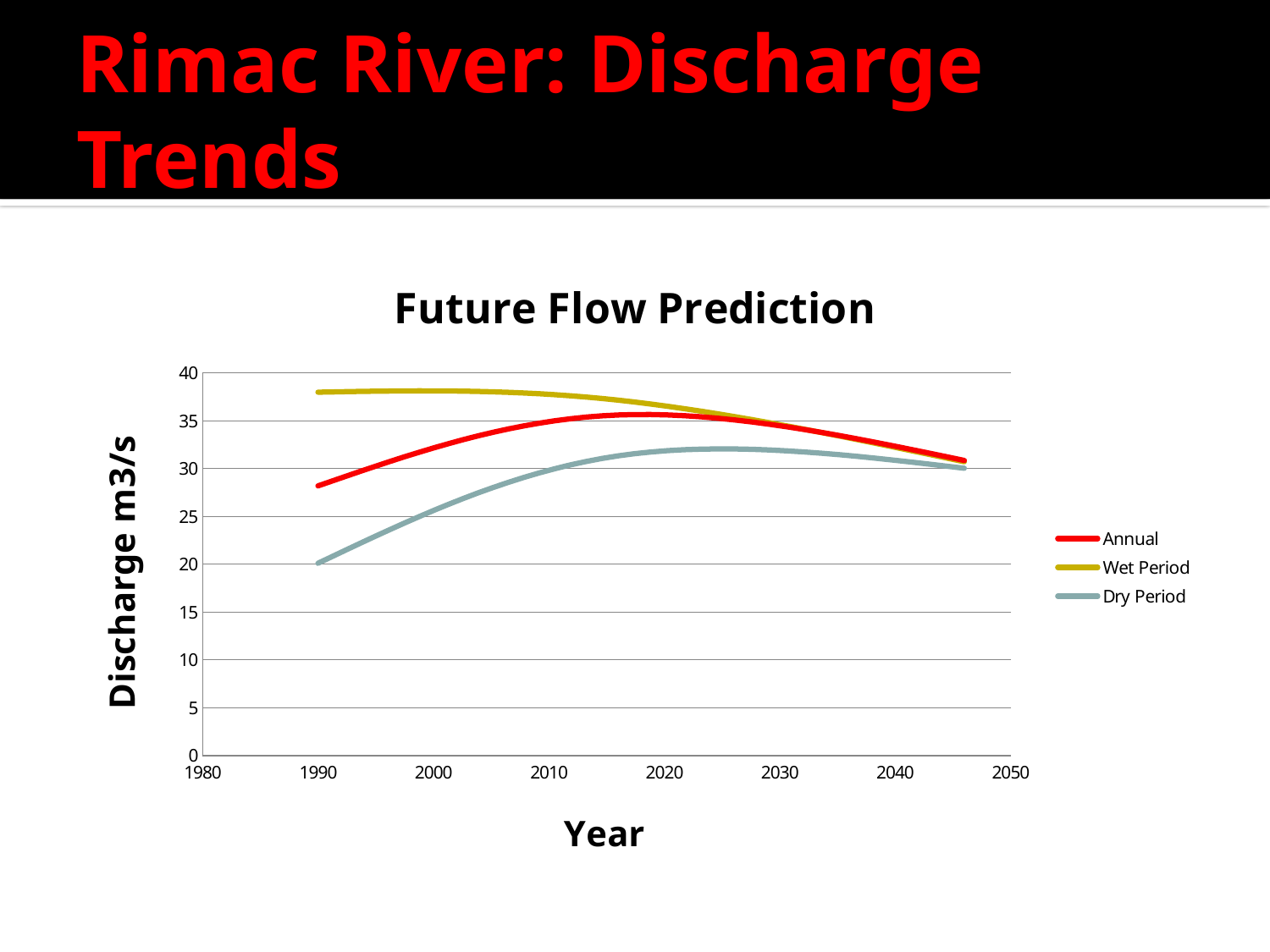
Does the Dry Period line rise or fall between 1990 and 2020? rise Is the Dry Period value in 1990 greater or less than 25? less Is the Dry Period value in 2020 greater or less than 30? greater Which series has the highest value in 1990? Wet Period Is the Wet Period value in 1990 greater or less than 35? greater What kind of chart is shown on the slide? line chart What is the label of the vertical axis? Discharge m3/s In 2000, which is larger, the Annual value or the Dry Period value? Annual How many series does the legend list? 3 What is the title of the chart? Future Flow Prediction Which series has the lowest value in 1990? Dry Period